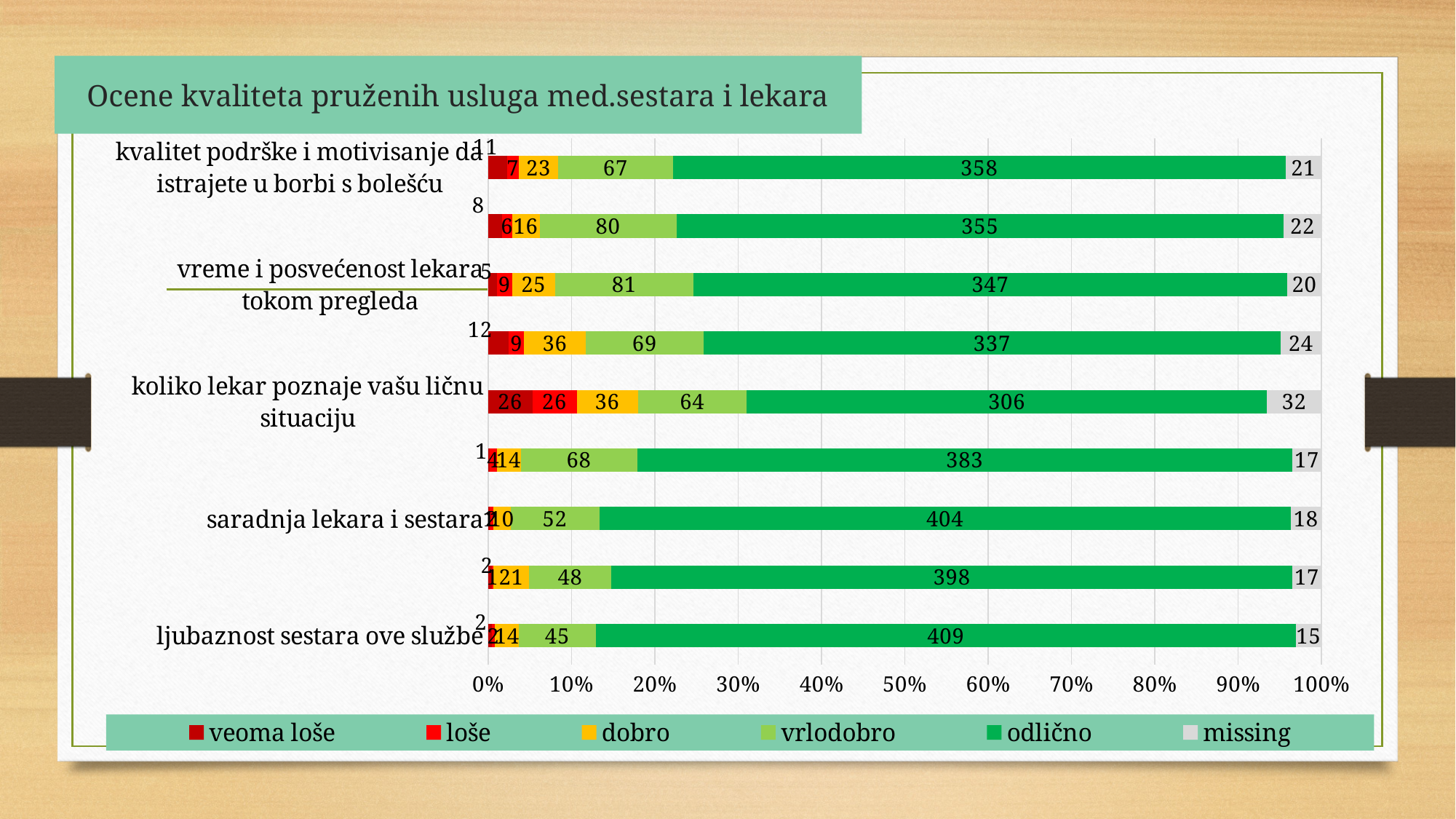
What is the 'odlično' value for 'ljubaznost sestara ove službe'? 409 What is the 'missing' value for 'koliko lekar poznaje vašu ličnu situaciju'? 32 How many bars (categories) are plotted in the chart? 9 What kind of chart is shown on the slide? Stacked bar chart How many series does the legend list? 6 Which category has the lowest 'odlično' value? koliko lekar poznaje vašu ličnu situaciju What is the 'dobro' value for 'koliko lekar poznaje vašu ličnu situaciju'? 36 Which category has the highest 'odlično' value? ljubaznost sestara ove službe What is the 'vrlodobro' value for 'vreme i posvećenost lekara tokom pregleda'? 81 What is the 'odlično' value for 'saradnja lekara i sestara'? 404 Which has the larger 'odlično' value: 'kvalitet podrške i motivisanje da istrajete u borbi s bolešću' or 'vreme i posvećenost lekara tokom pregleda'? kvalitet podrške i motivisanje da istrajete u borbi s bolešću What is the difference between the 'odlično' values for 'ljubaznost sestara ove službe' and 'koliko lekar poznaje vašu ličnu situaciju'? 103